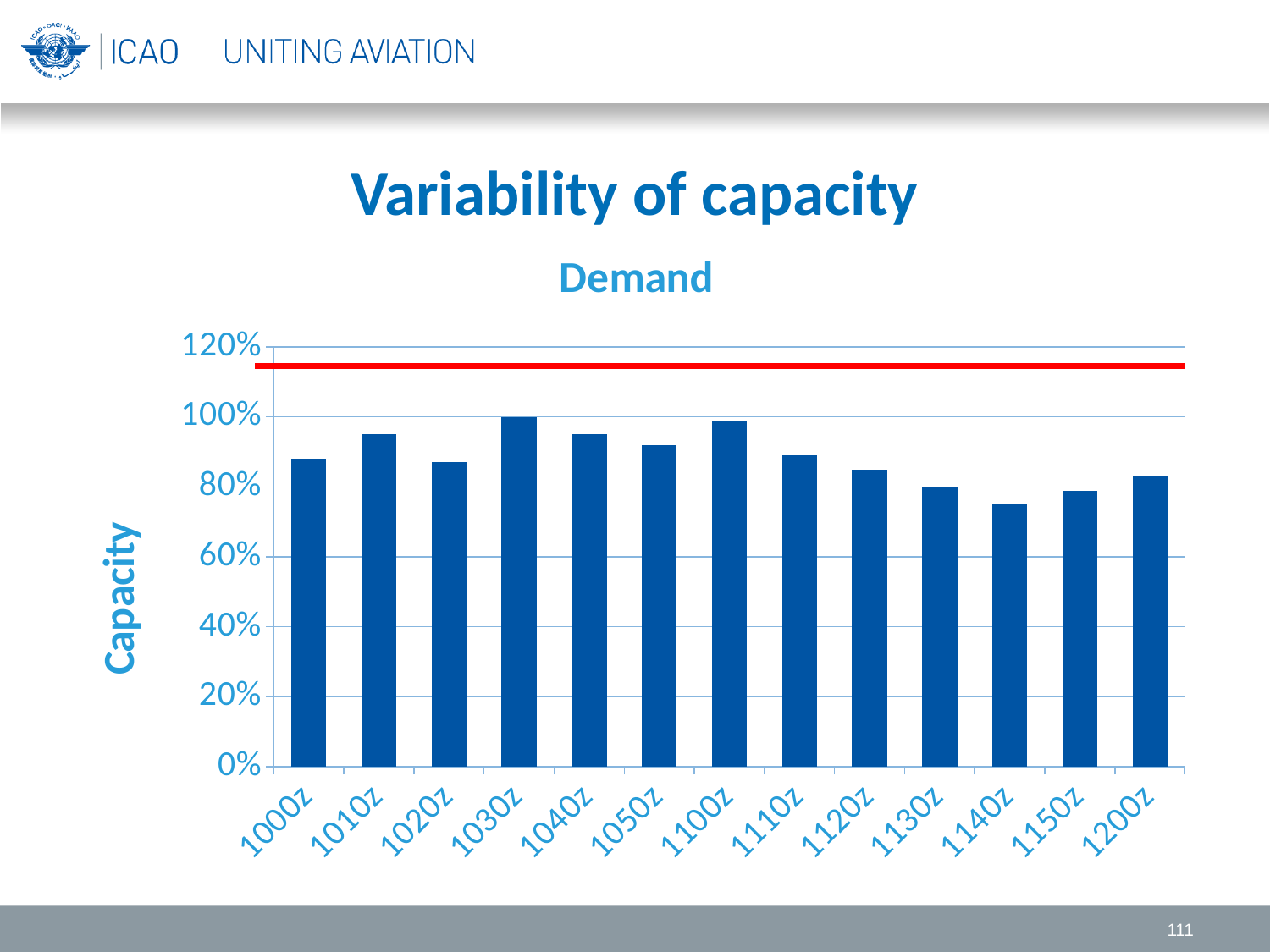
Which is larger, the value for 1140Z or the value for 1200Z? 1200Z Which time has the lowest bar in the chart? 1140Z Is the value for 1030Z greater or less than 80%? greater Do the values rise or fall from 1100Z to 1140Z? fall Is the value for 1000Z greater or less than 100%? less Which is larger, the value for 1010Z or the value for 1020Z? 1010Z What is the title of the chart? Demand How many time categories are shown on the x axis of the chart? 13 What is the label on the vertical axis of the chart? Capacity Is the value for 1140Z greater or less than 80%? less What kind of chart is shown on the slide? Bar chart